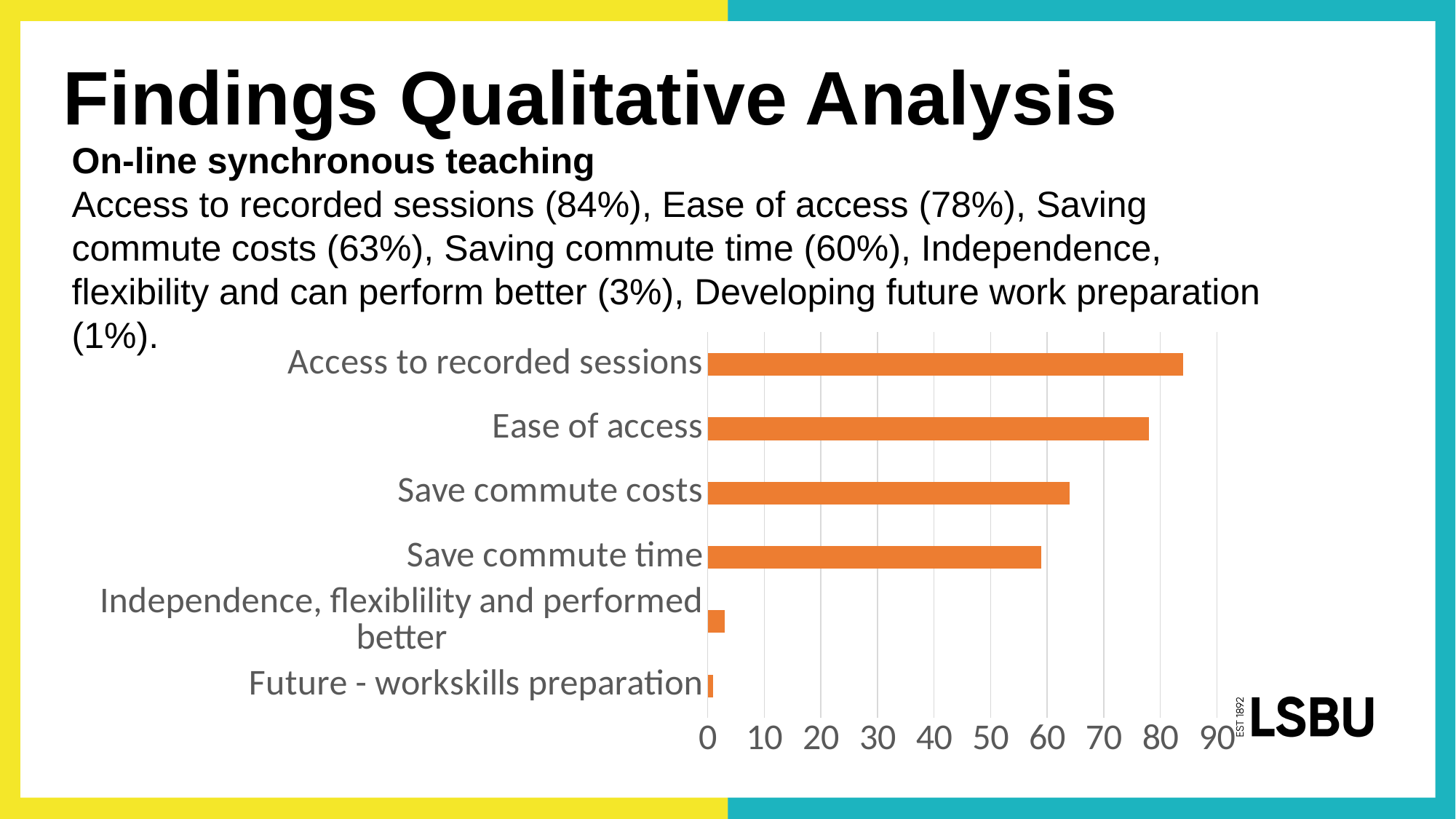
What colour are the bars in the chart? orange Is the value for Ease of access greater or less than 70? greater Is the value for Access to recorded sessions greater or less than 80? greater Which is larger, the value for Ease of access or the value for Save commute costs? Ease of access Which is larger, the value for Save commute time or the value for Future - workskills preparation? Save commute time Is the value for Save commute time greater or less than 50? greater Which category has the highest value in the bar chart? Access to recorded sessions How many categories does the bar chart show? 6 What kind of chart is shown on the slide? bar chart Which category has the lowest value in the bar chart? Future - workskills preparation